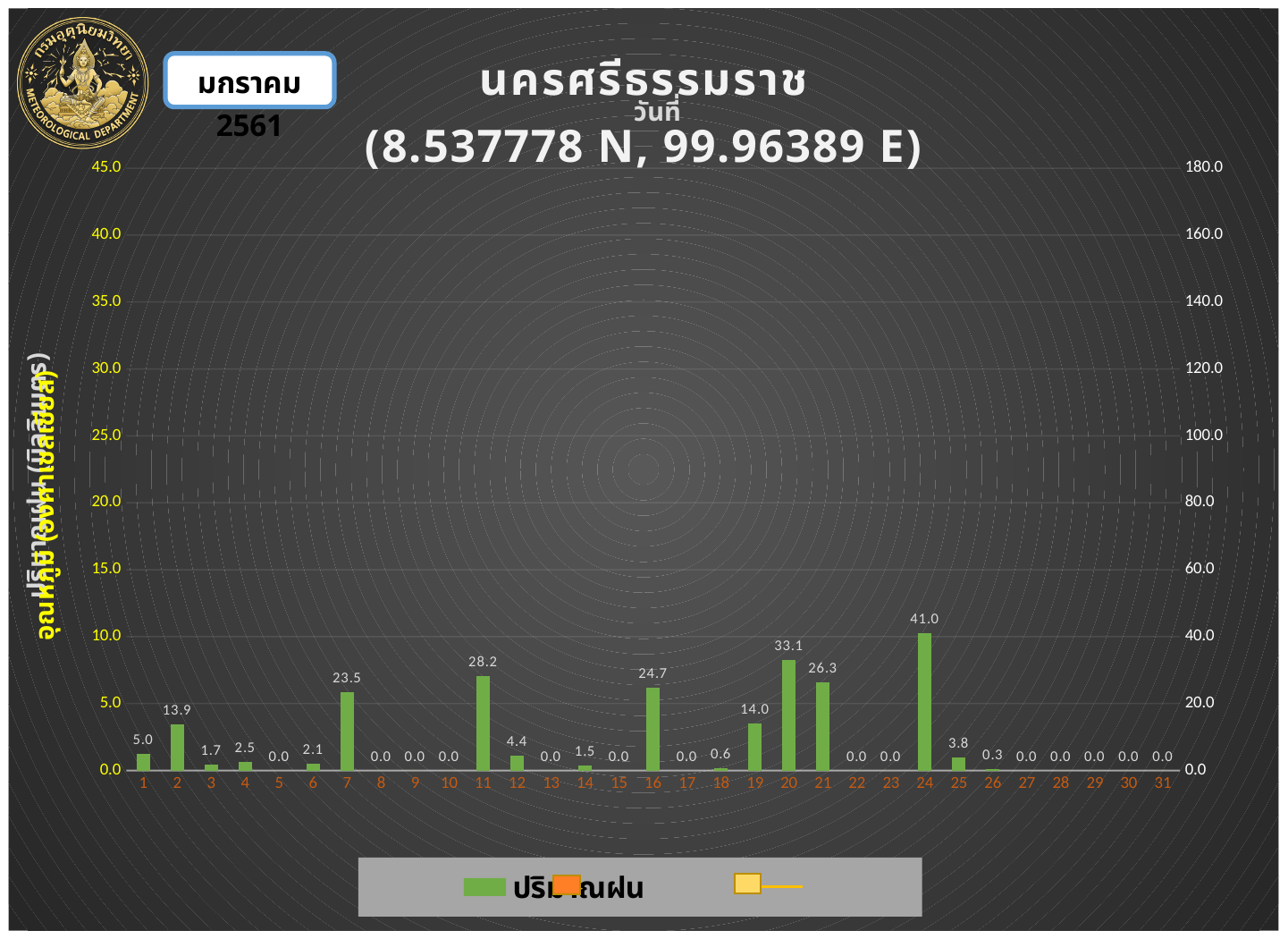
What are the coordinates shown in the chart title? 8.537778 N, 99.96389 E What is the rainfall value shown for day 24? 41.0 What is the difference between the values for day 24 and day 11? 12.8 Which day has the highest bar in the chart? 24 What is the value labelled on the bar for day 11? 28.2 What kind of chart is used to show the daily values? bar chart Which is larger, the value for day 19 or the value for day 2? day 19 Which is larger, the value for day 7 or the value for day 16? day 16 How many days (categories) are shown on the x axis? 31 What is the difference between the values for day 20 and day 21? 6.8 What is the value labelled on the bar for day 2? 13.9 What is the value labelled on the bar for day 26? 0.3